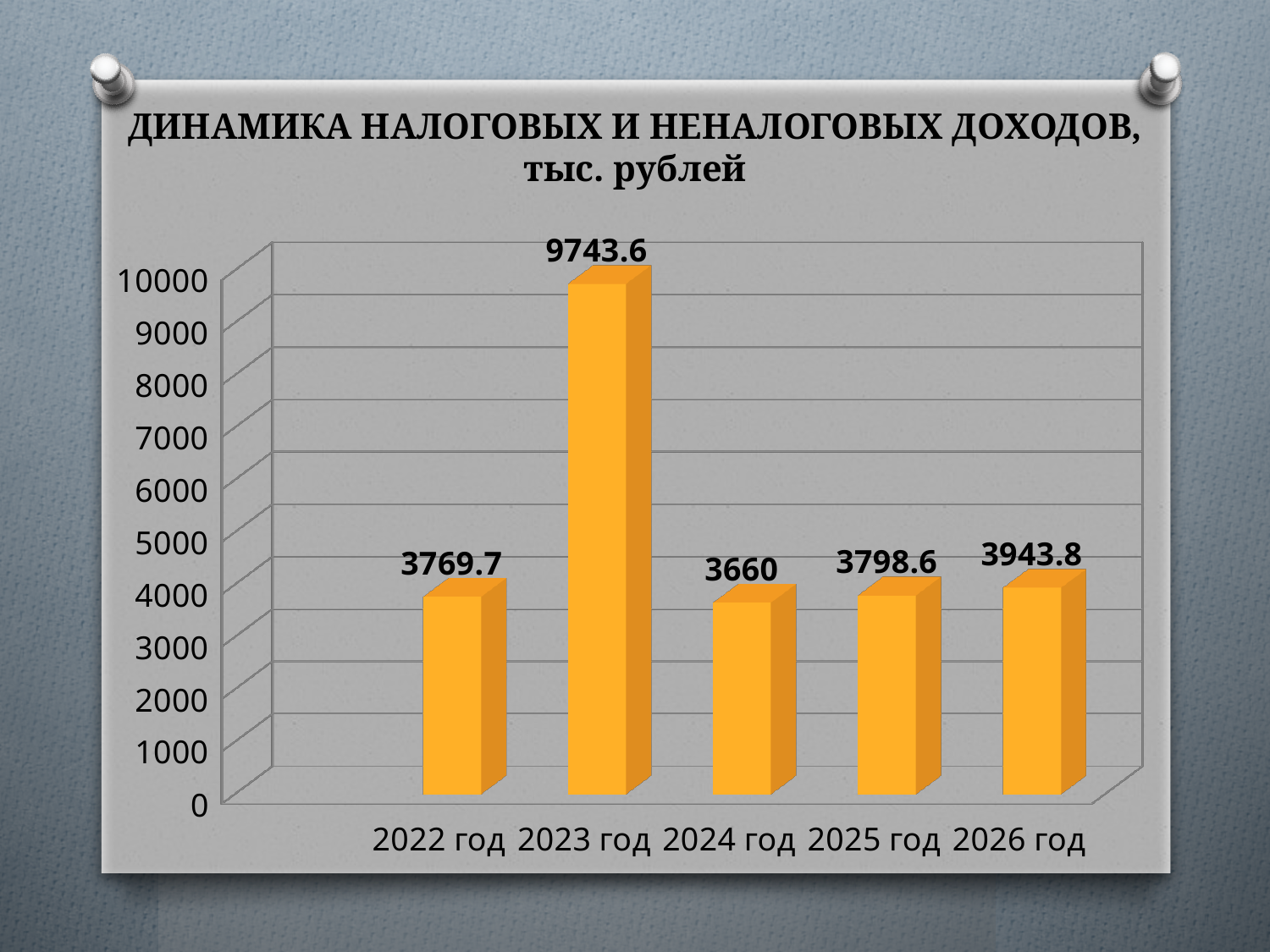
What kind of chart is shown on the slide? bar chart Which year has the highest value? 2023 год What is the difference between the values for 2026 год and 2024 год? 283.8 How many years are shown on the x axis? 5 Do the values rise or fall from 2024 год to 2026 год? rise What is the value for 2023 год? 9743.6 What is the value for 2026 год? 3943.8 Which is larger, the value for 2025 год or the value for 2024 год? 2025 год Is the value for 2022 год greater or less than 4000? less What is the value for 2024 год? 3660 What is the difference between the values for 2023 год and 2022 год? 5973.9 Which year has the lowest value? 2024 год